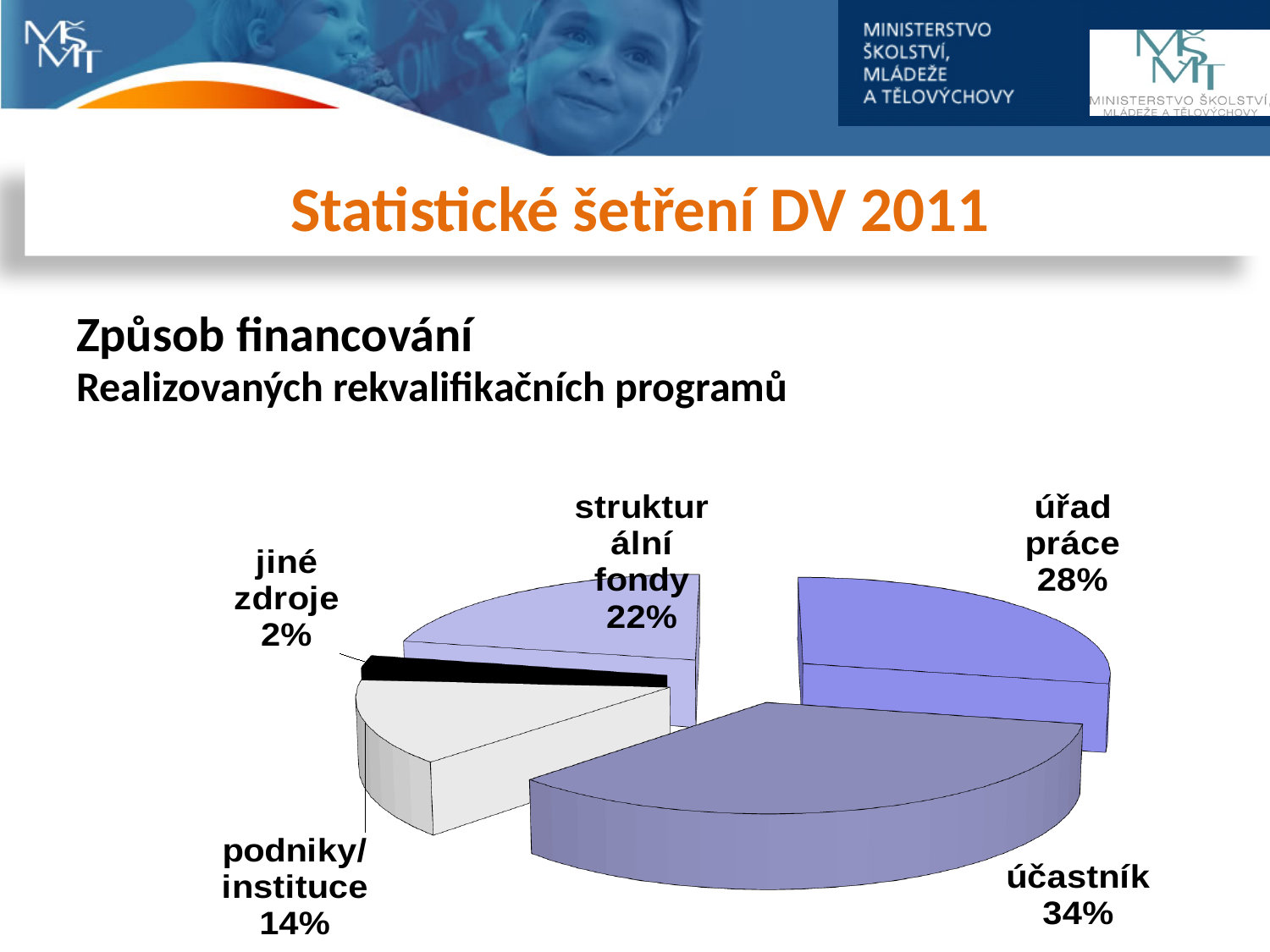
Which category has the largest share of the pie? účastník What is the difference in percentage points between účastník and úřad práce? 6 What is the value for jiné zdroje? 2% What percentage is shown for podniky/instituce? 14% What percentage is shown for úřad práce? 28% Which is larger, strukturální fondy or podniky/instituce? strukturální fondy What is the title of the slide? Statistické šetření DV 2011 What is the value for strukturální fondy? 22% How many categories are shown in the pie chart? 5 What kind of chart is shown on the slide? pie chart What share of the pie does účastník represent? 34% Which category has the smallest share of the pie? jiné zdroje